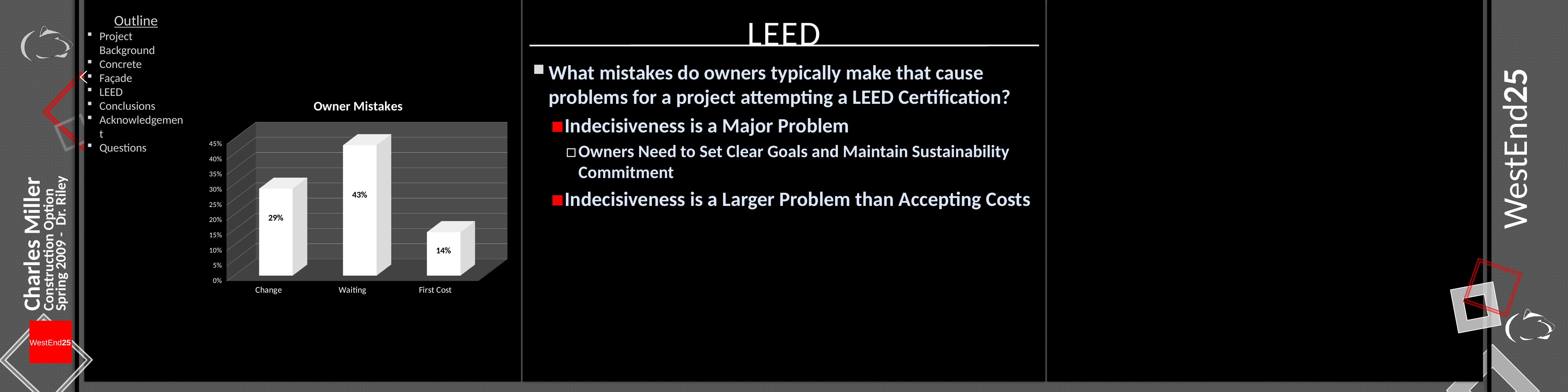
What kind of chart is the Owner Mistakes chart? bar chart What is the difference between the values for Change and First Cost in the Owner Mistakes chart? 15% Which category has the highest value in the Owner Mistakes chart? Waiting How many categories are shown in the Owner Mistakes chart? 3 Which is larger in the Owner Mistakes chart, Change or First Cost? Change What is the title of the chart on the slide? Owner Mistakes What is the value for Change in the Owner Mistakes chart? 29% What is the difference between the values for Waiting and Change in the Owner Mistakes chart? 14% What is the value for First Cost in the Owner Mistakes chart? 14% What is the value for Waiting in the Owner Mistakes chart? 43% Is the value for Waiting in the Owner Mistakes chart greater or less than 40%? greater Which category has the lowest value in the Owner Mistakes chart? First Cost